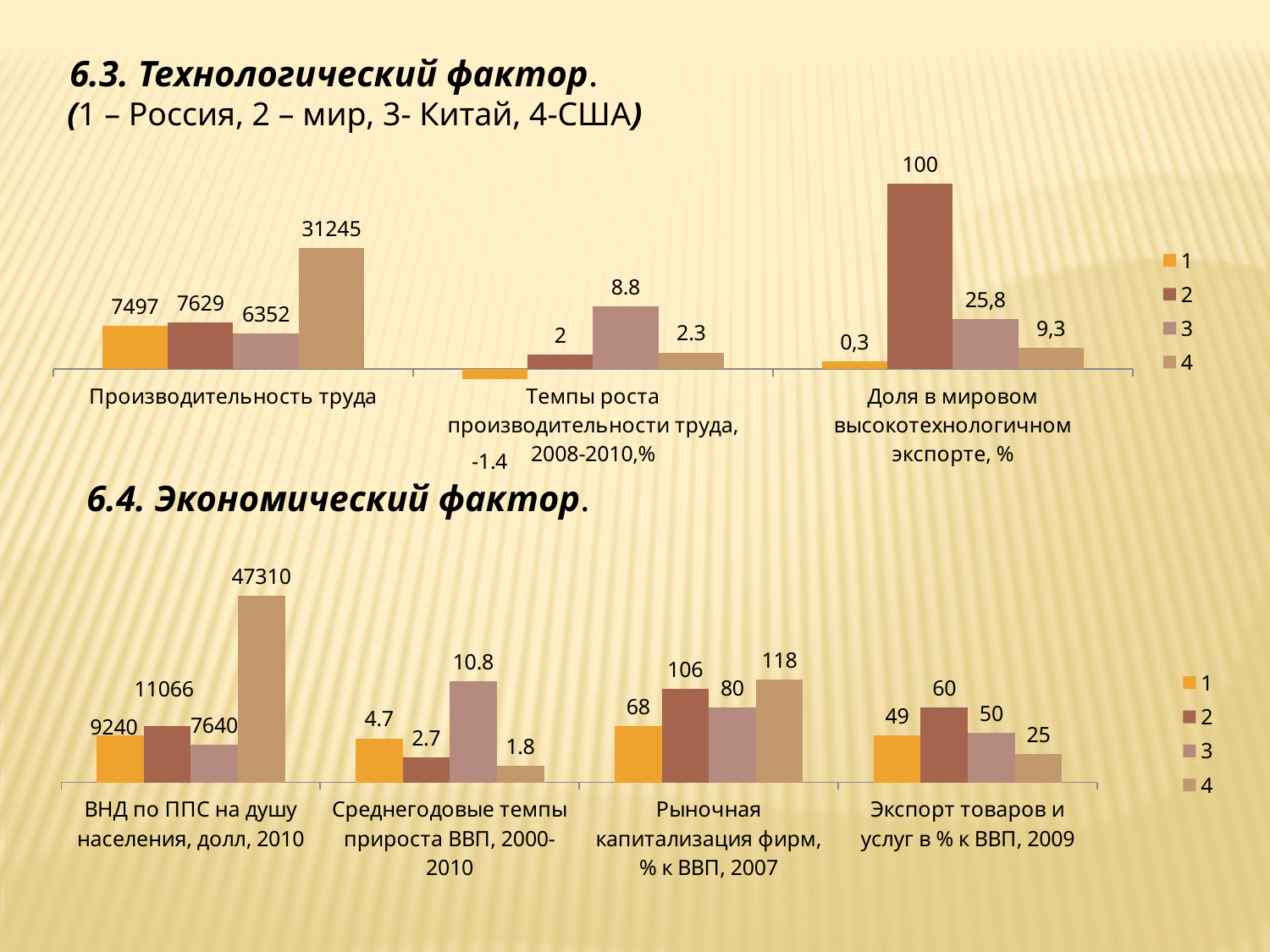
In the bottom chart (6.4. Экономический фактор), what is the difference between series 4 and series 2 for Рыночная капитализация фирм, % к ВВП, 2007? 12 In the bottom chart (6.4. Экономический фактор), what is the value of series 3 for Среднегодовые темпы прироста ВВП, 2000-2010? 10.8 In the top chart (6.3. Технологический фактор), what is the difference between series 2 and series 1 for Производительность труда? 132 In the bottom chart (6.4. Экономический фактор), what is the value of series 4 for ВНД по ППС на душу населения, долл, 2010? 47310 In the top chart (6.3. Технологический фактор), which series has the highest value for Доля в мировом высокотехнологичном экспорте, %? 2 In the top chart (6.3. Технологический фактор), what is the value of series 4 for Производительность труда? 31245 How many series does the legend of the top chart (6.3. Технологический фактор) list? 4 In the bottom chart (6.4. Экономический фактор), which series has the lowest value for Экспорт товаров и услуг в % к ВВП, 2009? 4 How many categories are shown on the x axis of the bottom chart (6.4. Экономический фактор)? 4 In the top chart (6.3. Технологический фактор), what is the value of series 1 for Темпы роста производительности труда, 2008-2010,%? -1.4 In the top chart (6.3. Технологический фактор), which is larger for Темпы роста производительности труда, 2008-2010,%: series 3 or series 4? 3 What type of chart is the bottom chart (6.4. Экономический фактор)? bar chart